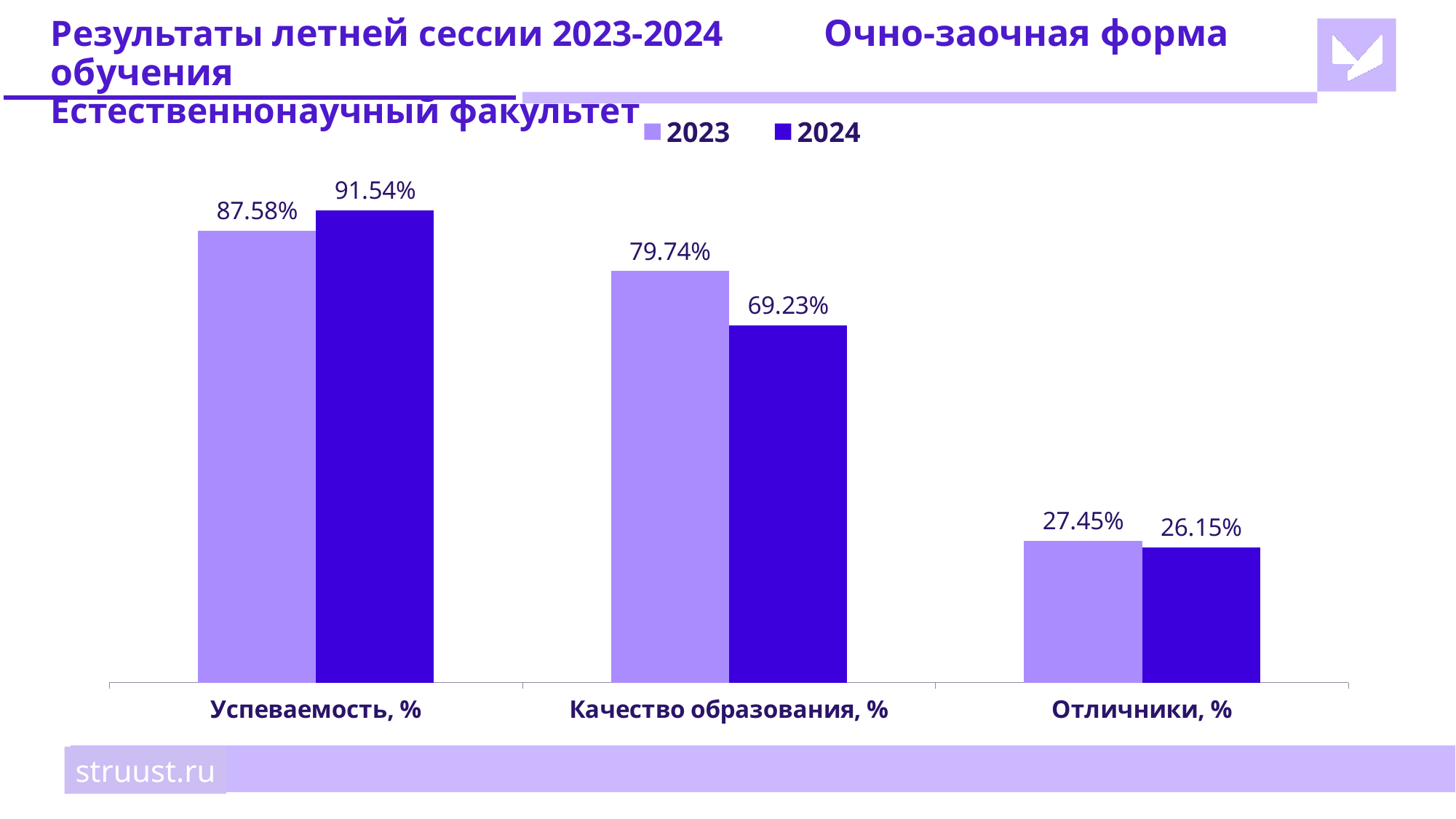
Which category has the highest 2024 value? Успеваемость, % How many series does the legend list? 2 How many categories are shown on the x axis? 3 What kind of chart is shown on the slide? Bar chart What is the difference between the 2023 and 2024 values for Качество образования, %? 10.51% What is the 2023 value for Отличники, %? 27.45% What is the 2023 value for Успеваемость, %? 87.58% What is the 2024 value for Качество образования, %? 69.23% Which category has the lowest 2023 value? Отличники, % What is the 2024 value for Успеваемость, %? 91.54% For Отличники, %, which year has the larger value, 2023 or 2024? 2023 What is the difference between the 2024 and 2023 values for Успеваемость, %? 3.96%